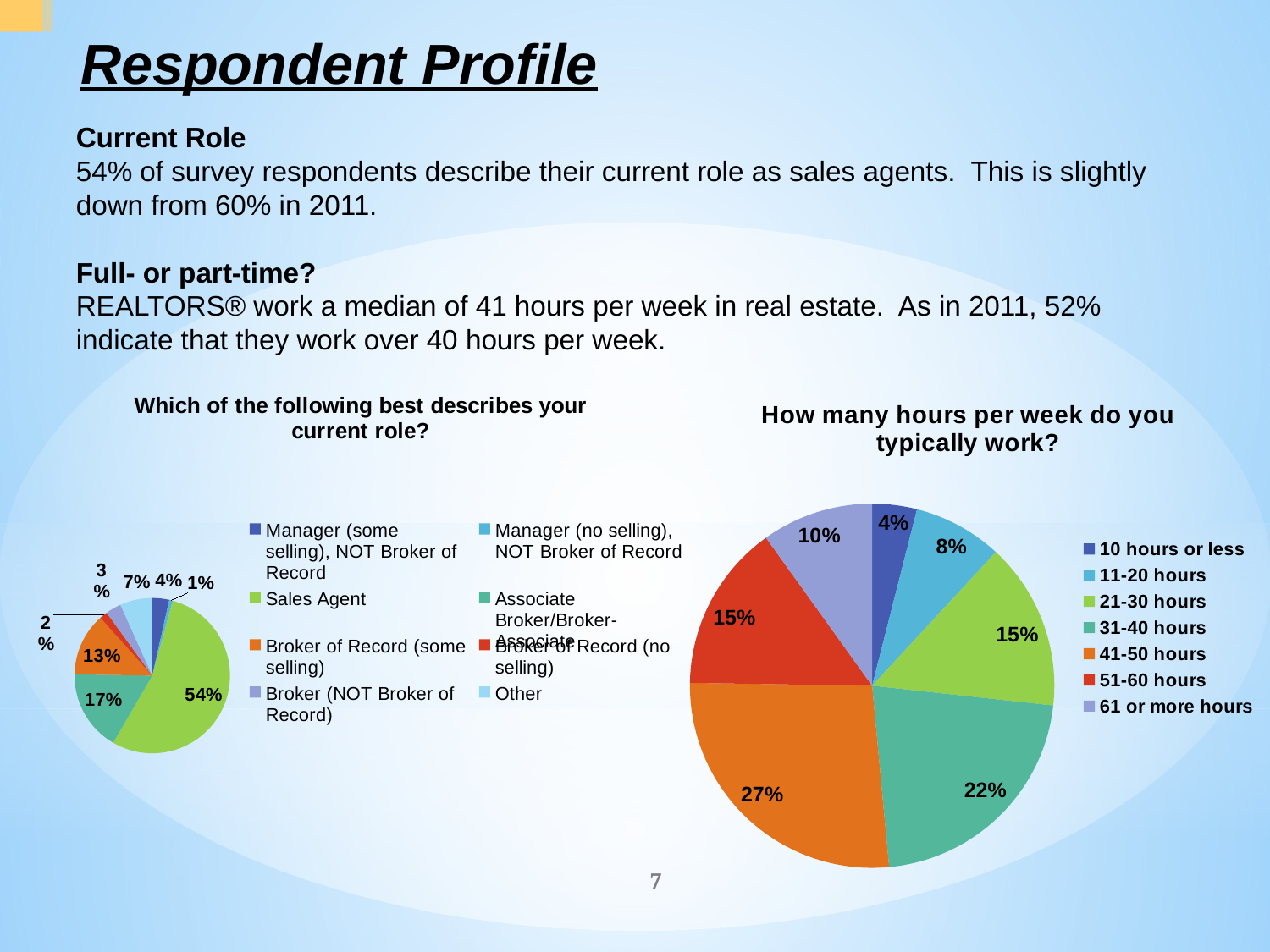
In the chart 'How many hours per week do you typically work?', which category has the smallest share? 10 hours or less What type of chart is used for 'How many hours per week do you typically work?' Pie chart In the chart 'How many hours per week do you typically work?', what share of respondents work 41-50 hours? 27% In the chart 'Which of the following best describes your current role?', which role has the largest share? Sales Agent In the chart 'How many hours per week do you typically work?', what share of respondents work 10 hours or less? 4% In the chart 'How many hours per week do you typically work?', what share of respondents work 31-40 hours? 22% In the chart 'How many hours per week do you typically work?', how many categories does the legend list? 7 In the chart 'Which of the following best describes your current role?', what share of respondents are Sales Agents? 54% In the chart 'How many hours per week do you typically work?', what is the difference between the 41-50 hours share and the 11-20 hours share? 19 percentage points In the chart 'How many hours per week do you typically work?', which category has the largest share? 41-50 hours In the chart 'Which of the following best describes your current role?', what share of respondents are Associate Broker/Broker-Associate? 17% In the chart 'How many hours per week do you typically work?', which is larger: the share for 61 or more hours or the share for 11-20 hours? 61 or more hours